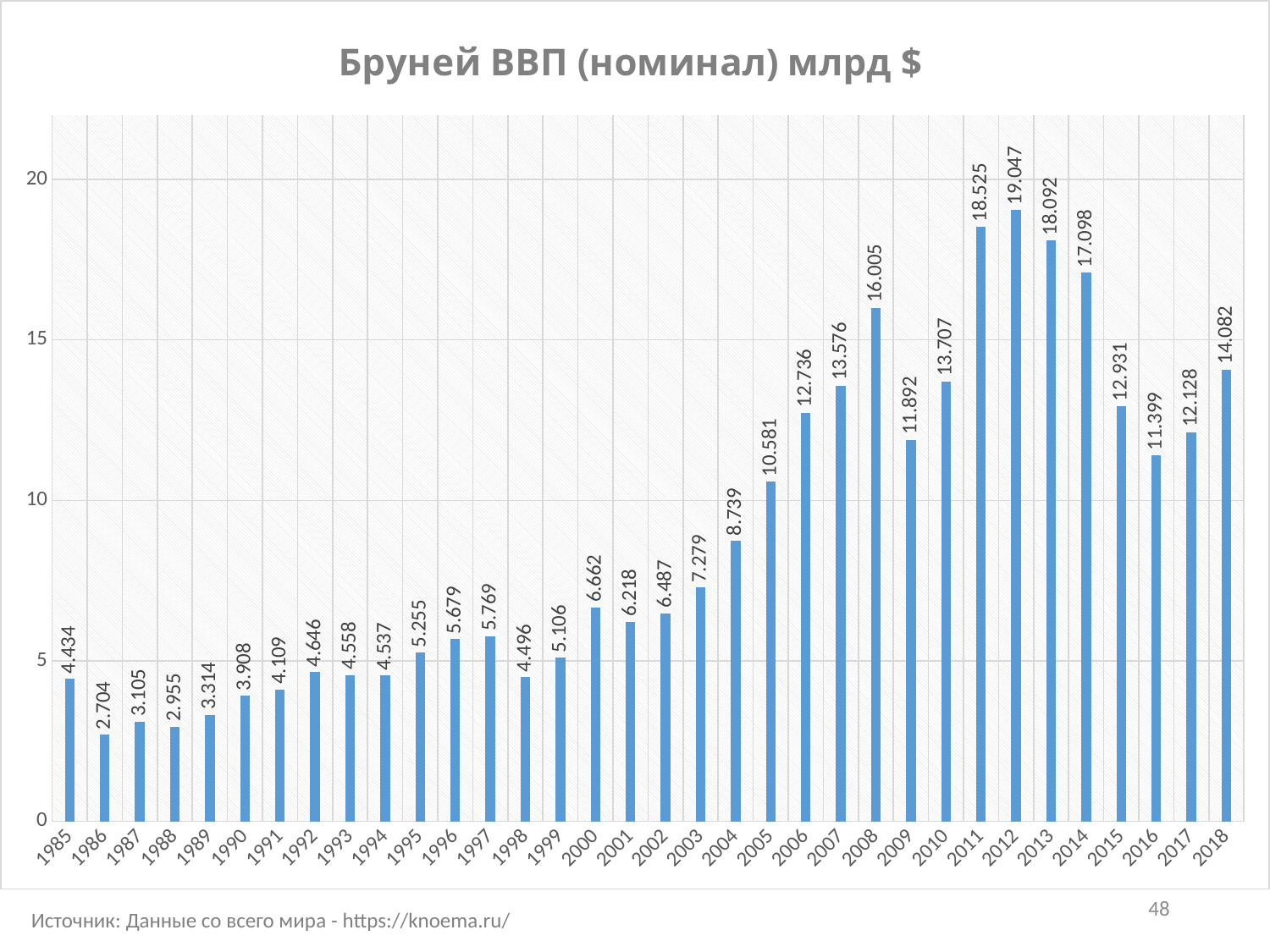
Which year has the highest value? 2012 What is the difference between the values for 2018 and 2017? 1.954 Which is larger, the value for 2008 or the value for 2010? 2008 How many years (bars) are shown in the chart? 34 What is the value for 2008? 16.005 What type of chart is shown on the slide? bar chart Is the value for 2005 greater or less than 10? greater What is the value for 2012? 19.047 What is the title of the chart? Бруней ВВП (номинал) млрд $ Which year has the lowest value? 1986 Do the values rise or fall from 2004 to 2008? rise What is the value for 1985? 4.434